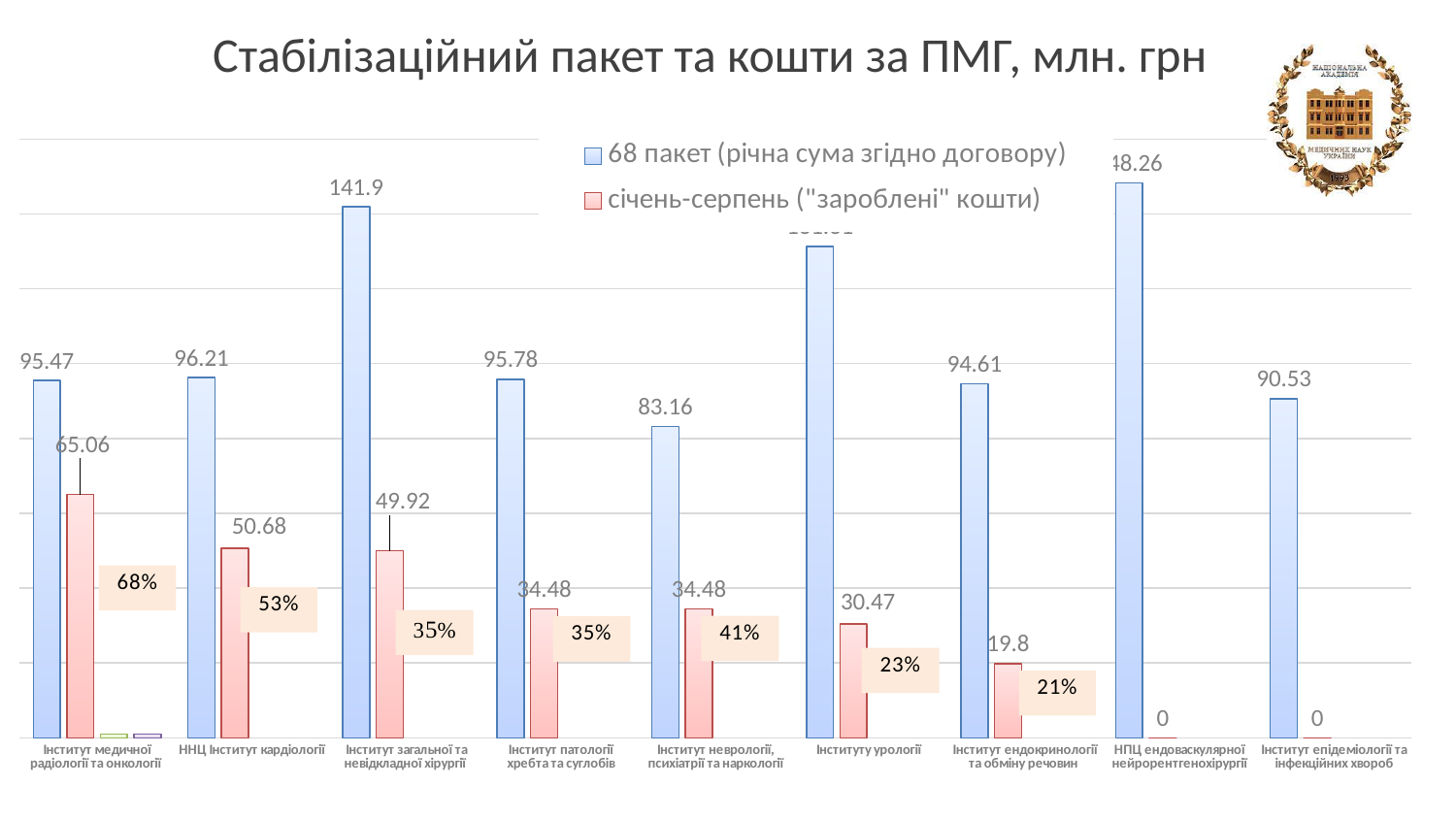
How many institutes (categories) are shown on the x axis? 9 Which institute has the highest value in the 'січень-серпень ("зароблені" кошти)' series? Інститут медичної радіології та онкології What is the value of the 'січень-серпень ("зароблені" кошти)' series for Інститут ендокринології та обміну речовин? 19.8 Which is larger: the 'січень-серпень' value for Інститут медичної радіології та онкології or for ННЦ Інститут кардіології? Інститут медичної радіології та онкології What percentage label is shown for Інститут медичної радіології та онкології? 68% What is the value of the 'січень-серпень ("зароблені" кошти)' series for ННЦ Інститут кардіології? 50.68 What is the difference between the '68 пакет' value and the 'січень-серпень' value for Інститут загальної та невідкладної хірургії? 91.98 Which institute has the highest value in the '68 пакет (річна сума згідно договору)' series? НПЦ ендоваскулярної нейрорентгенохірургії What is the difference between the '68 пакет' value and the 'січень-серпень' value for Інститут медичної радіології та онкології? 30.41 What is the value of the '68 пакет (річна сума згідно договору)' series for Інститут загальної та невідкладної хірургії? 141.9 How many series does the legend list? 2 Which institute has the lowest value in the '68 пакет (річна сума згідно договору)' series? Інститут неврології, психіатрії та наркології